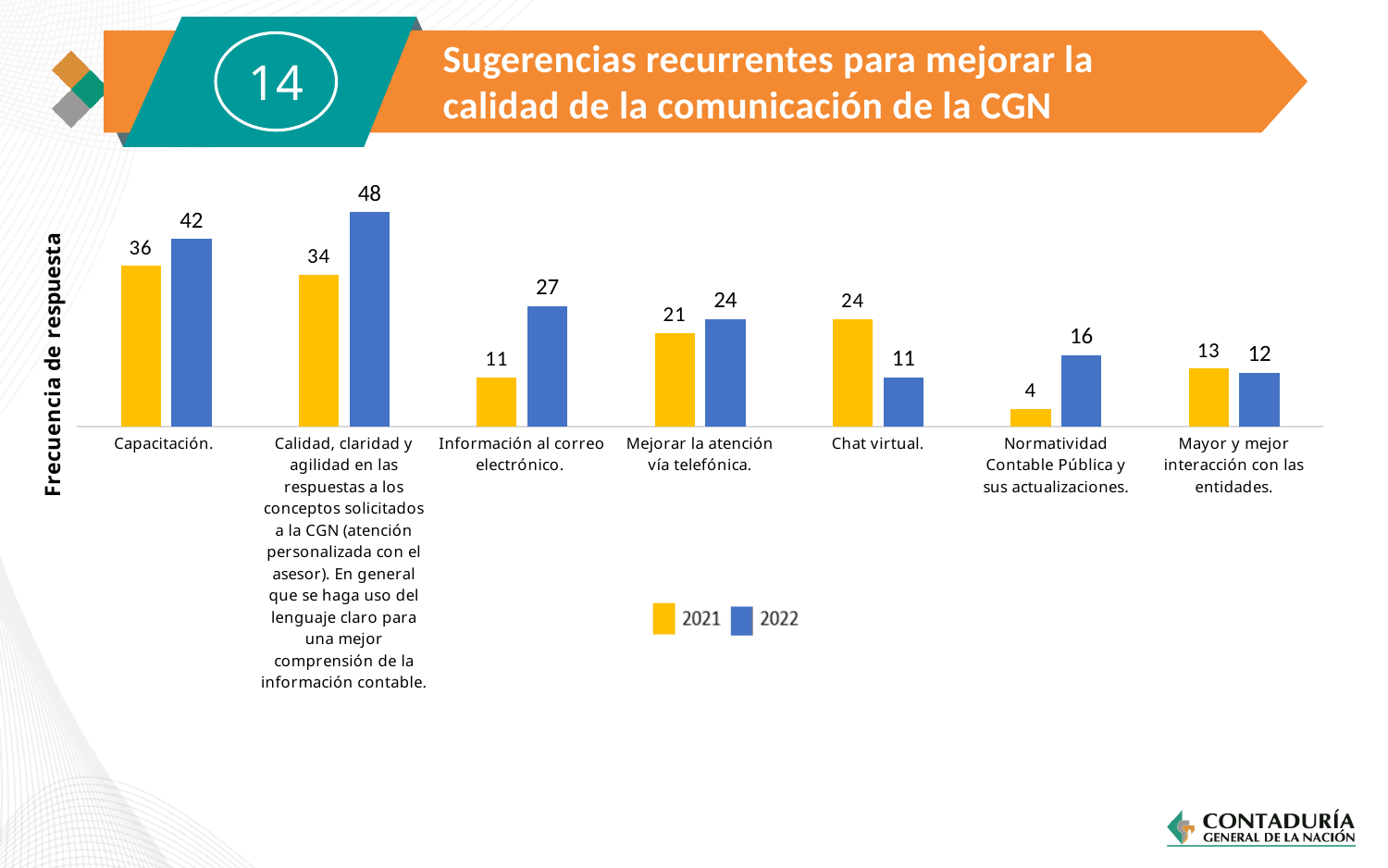
What is the 2021 value for Normatividad Contable Pública y sus actualizaciones? 4 How many series does the legend list? 2 Which category has the highest 2022 value? Calidad, claridad y agilidad en las respuestas a los conceptos solicitados a la CGN What is the label of the vertical axis? Frecuencia de respuesta What is the difference between the 2022 and 2021 values for Información al correo electrónico? 16 What is the 2021 value for Chat virtual? 24 For Chat virtual, which year has the larger value, 2021 or 2022? 2021 Which category has the lowest 2021 value? Normatividad Contable Pública y sus actualizaciones Which colour represents the 2021 series? Yellow How many categories are shown on the x axis? 7 What kind of chart is shown on the slide? Bar chart What is the 2022 value for Capacitación? 42